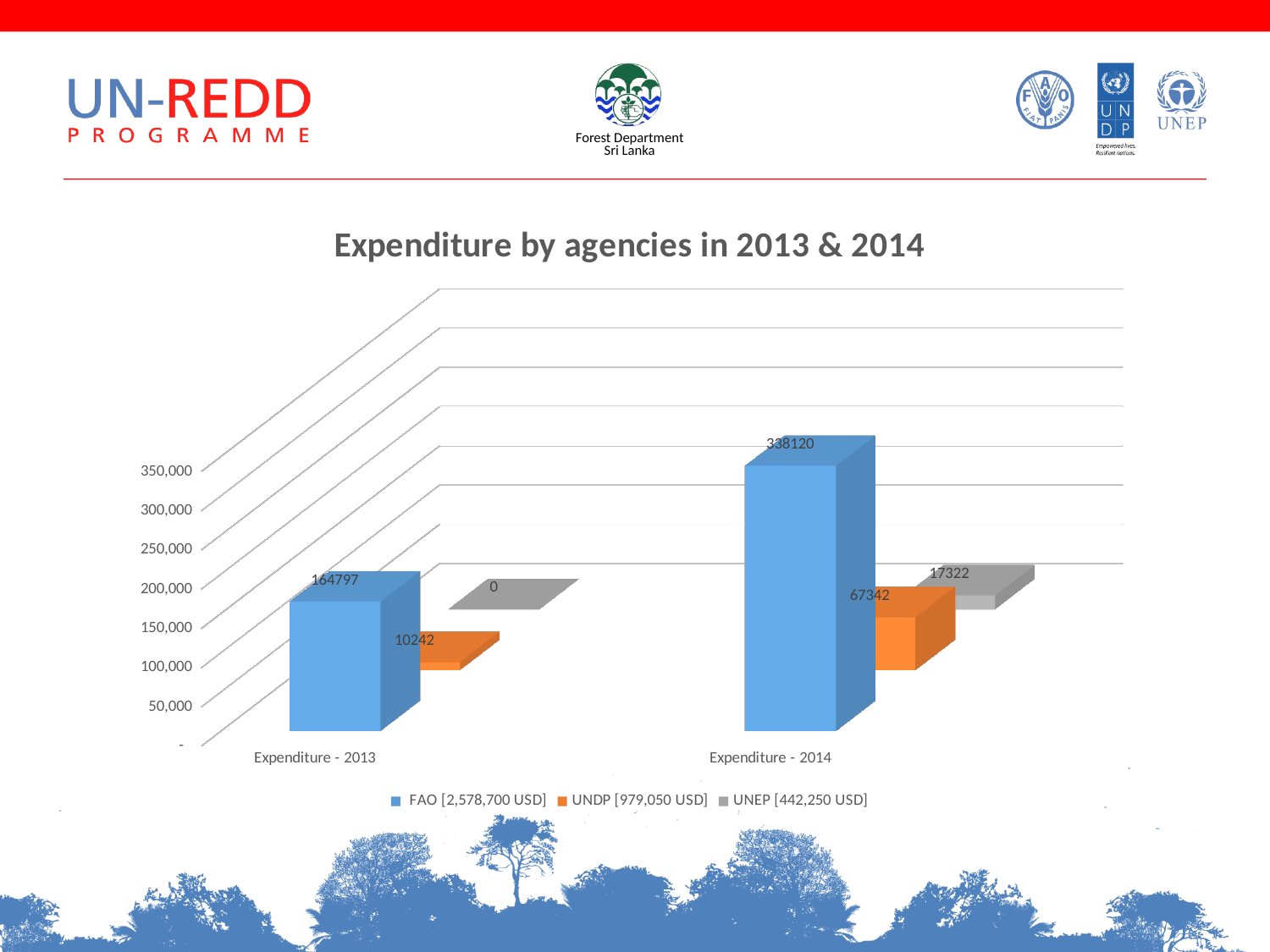
What is the UNDP expenditure value for Expenditure - 2014? 67342 What is the UNEP expenditure value for Expenditure - 2014? 17322 What is the title of the chart? Expenditure by agencies in 2013 & 2014 What is the FAO expenditure value for Expenditure - 2013? 164797 Which agency has the highest expenditure in Expenditure - 2014? FAO Which is larger, the UNDP expenditure in 2013 or the UNEP expenditure in 2014? UNEP expenditure in 2014 What is the UNEP expenditure value for Expenditure - 2013? 0 What is the difference between the UNDP expenditure in 2014 and in 2013? 57100 Which agency has the lowest expenditure in Expenditure - 2013? UNEP How many series does the legend list? 3 What is the difference between the FAO expenditure in 2014 and in 2013? 173323 What kind of chart is shown on the slide? Bar chart